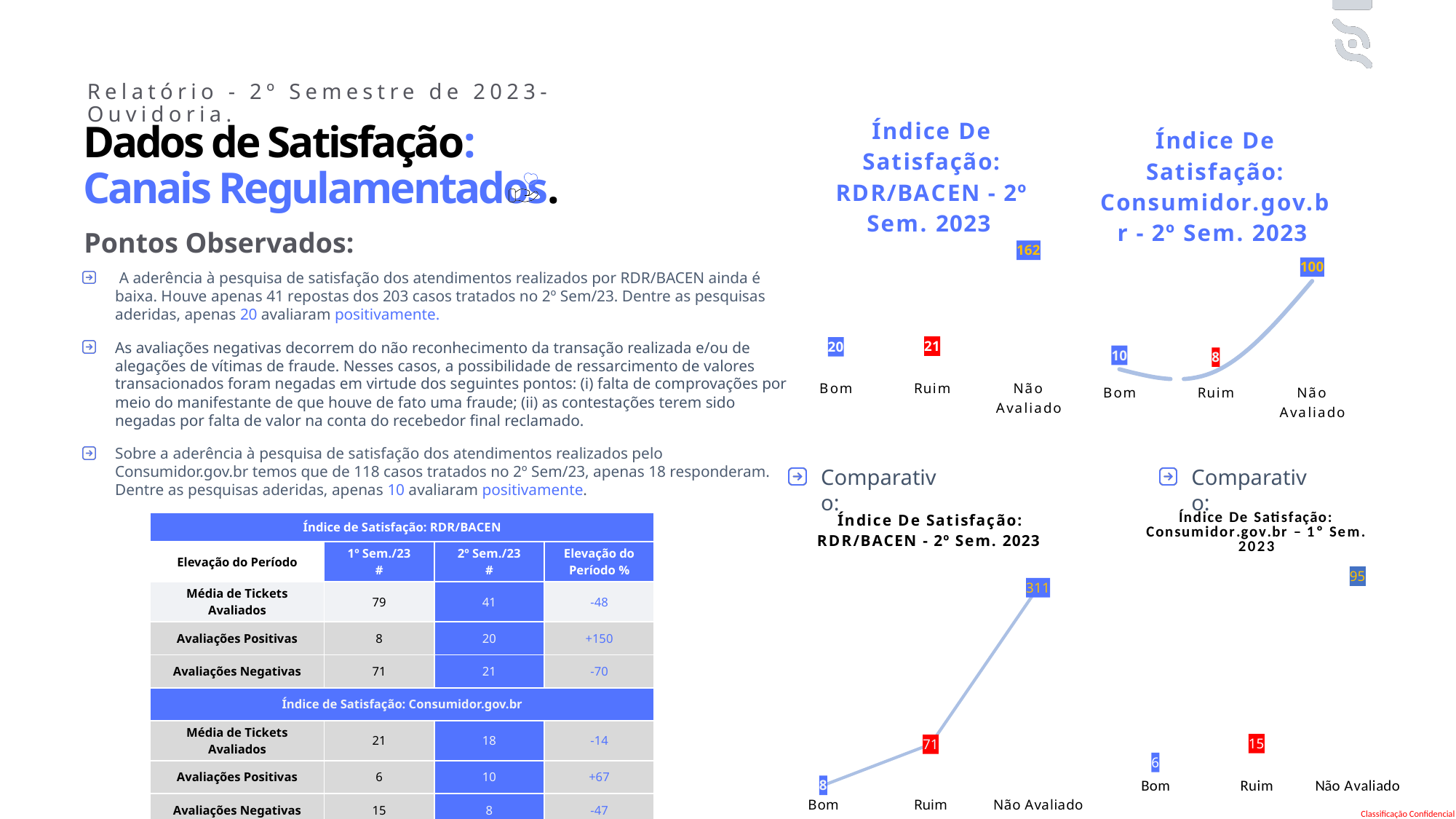
In the top-left chart titled 'Índice De Satisfação: RDR/BACEN - 2º Sem. 2023', what is the value for Não Avaliado? 162 In the top-right chart titled 'Índice De Satisfação: Consumidor.gov.br - 2º Sem. 2023', which category has the highest value? Não Avaliado In the top-right chart titled 'Índice De Satisfação: Consumidor.gov.br - 2º Sem. 2023', what is the value for Ruim? 8 In the top-right chart titled 'Índice De Satisfação: Consumidor.gov.br - 2º Sem. 2023', what kind of chart is shown? Line chart In the bottom-right chart titled 'Índice De Satisfação: Consumidor.gov.br – 1° Sem. 2023', what is the value for Ruim? 15 In the bottom-left comparative chart titled 'Índice De Satisfação: RDR/BACEN - 2º Sem. 2023', do the values rise or fall from Bom to Não Avaliado? Rise In the bottom-left comparative chart titled 'Índice De Satisfação: RDR/BACEN - 2º Sem. 2023', what is the value for Não Avaliado? 311 In the top-left chart titled 'Índice De Satisfação: RDR/BACEN - 2º Sem. 2023', what is the difference between Ruim and Bom? 1 In the top-right chart titled 'Índice De Satisfação: Consumidor.gov.br - 2º Sem. 2023', how many categories are shown on the x axis? 3 In the bottom-right chart titled 'Índice De Satisfação: Consumidor.gov.br – 1° Sem. 2023', which is larger, Bom or Ruim? Ruim In the bottom-left comparative chart titled 'Índice De Satisfação: RDR/BACEN - 2º Sem. 2023', which category has the lowest value? Bom In the top-left chart titled 'Índice De Satisfação: RDR/BACEN - 2º Sem. 2023', what is the value for Bom? 20